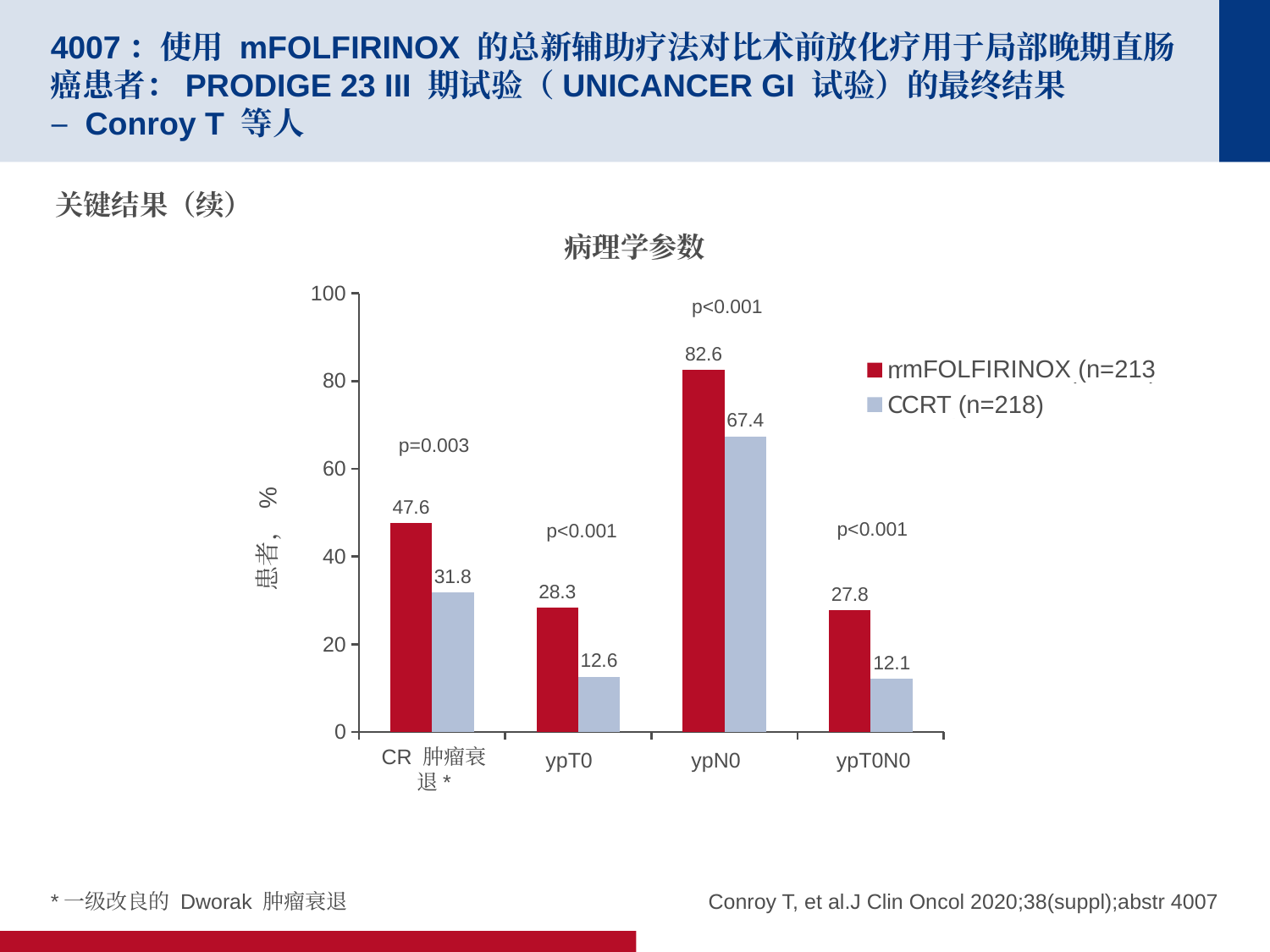
Which category has the highest value for the CCRT series? ypN0 What is the difference between the mFOLFIRINOX and CCRT values in the ypN0 category? 15.2 What is the title of the chart? 病理学参数 How many series does the legend list? 2 Which category has the lowest value for the mFOLFIRINOX series? ypT0N0 What is the value for CCRT in the ypT0N0 category? 12.1 What is the value for CCRT in the ypT0 category? 12.6 What is the value for mFOLFIRINOX in the CR 肿瘤衰退 category? 47.6 What type of chart is shown on the slide? Bar chart What is the value for mFOLFIRINOX in the ypN0 category? 82.6 Which is larger in the CR 肿瘤衰退 category: the mFOLFIRINOX value or the CCRT value? mFOLFIRINOX How many categories are shown on the x axis? 4